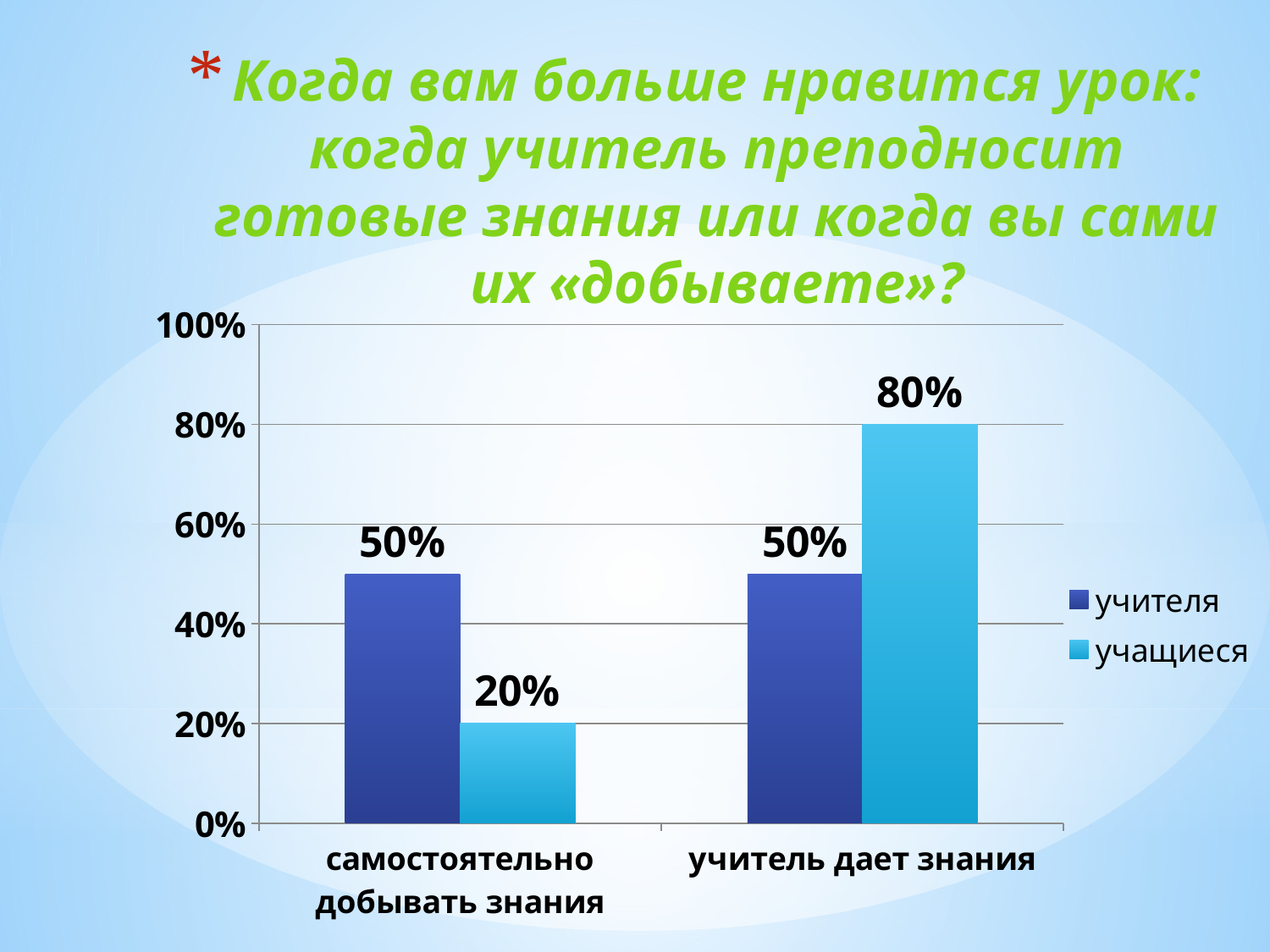
In the category учитель дает знания, which series has the larger value, учителя or учащиеся? учащиеся What is the value for учителя in the category учитель дает знания? 50% What is the value for учителя in the category самостоятельно добывать знания? 50% In the category самостоятельно добывать знания, which series has the larger value, учителя or учащиеся? учителя How many series does the legend list? 2 How many categories are shown on the x axis? 2 What is the value for учащиеся in the category учитель дает знания? 80% Which category has the lowest value for the учащиеся series? самостоятельно добывать знания What is the difference between the учащиеся values for учитель дает знания and самостоятельно добывать знания? 60% Which category has the highest value for the учащиеся series? учитель дает знания What kind of chart is shown on the slide? bar chart What is the value for учащиеся in the category самостоятельно добывать знания? 20%